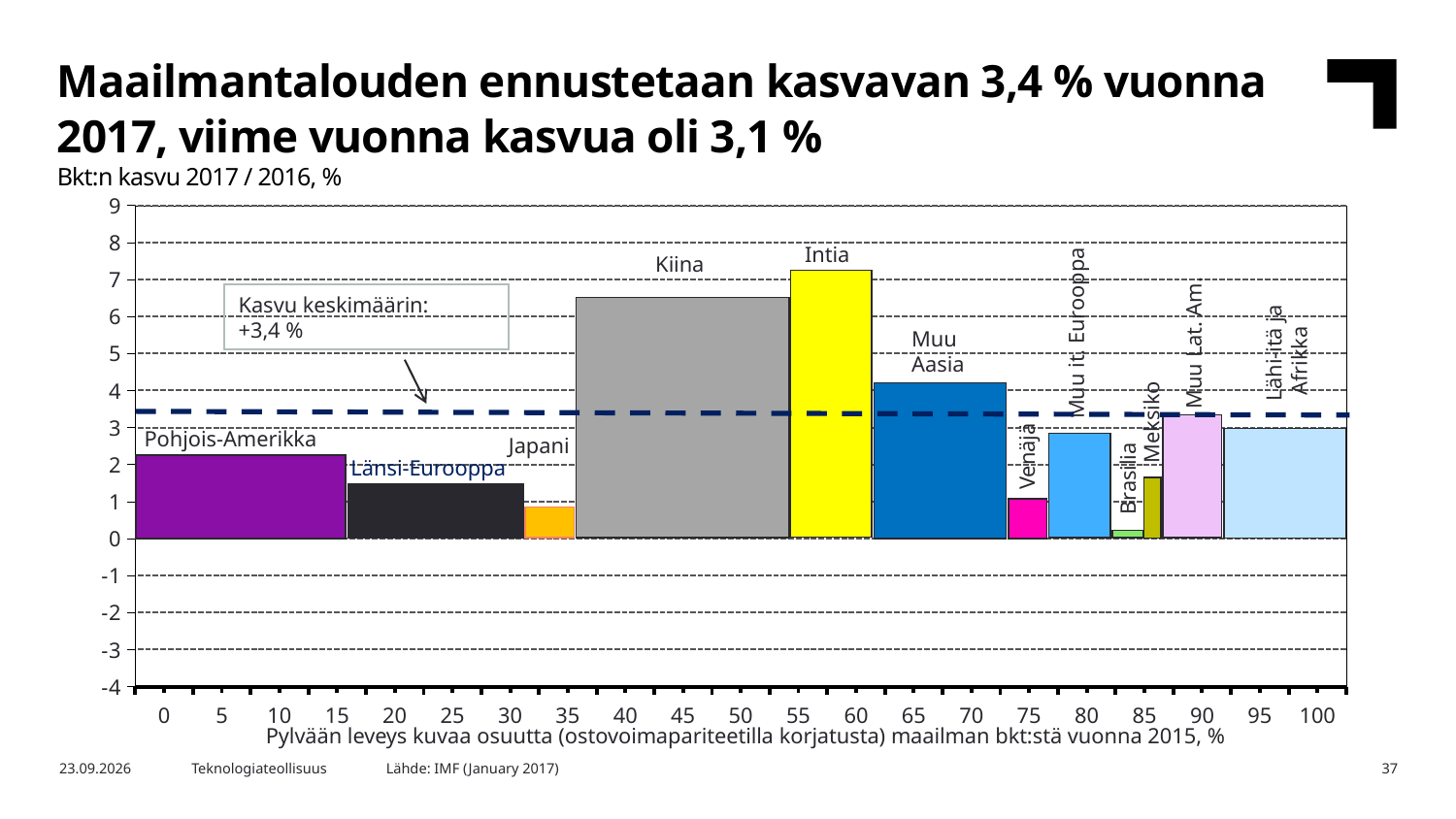
Is the value for Kiina greater or less than 6? greater Which region has the lowest GDP growth in the chart? Brasilia According to the note below the x axis, what does the width of each bar represent? Share of world GDP in 2015 (PPP-adjusted), % Which has higher GDP growth, Pohjois-Amerikka or Länsi-Eurooppa? Pohjois-Amerikka Which has higher GDP growth, Kiina or Intia? Intia Which region has the highest GDP growth in the chart? Intia Is the value for Meksiko greater or less than 2? less What kind of chart is shown on the slide? Bar chart What average growth value is shown in the text box on the chart? +3,4 % Which has higher GDP growth, Muu Aasia or Muu it. Eurooppa? Muu Aasia How many regions (bars) are shown in the chart? 12